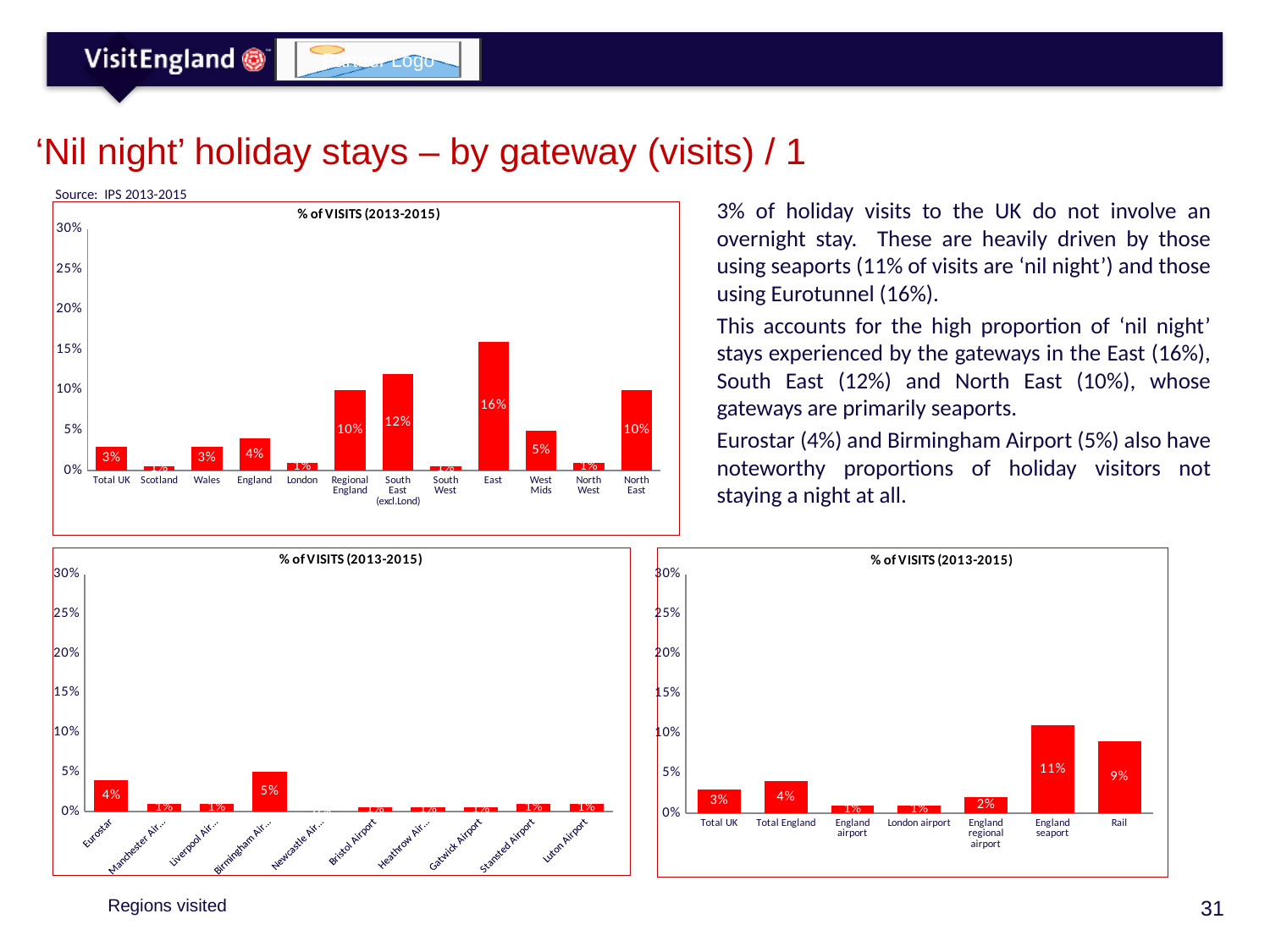
In the bottom-left chart, which category has the highest value? Birmingham Airport In the top-left chart, which is larger, Regional England or West Mids? Regional England In the bottom-right chart, what is the value for England seaport? 11% What type of chart is the bottom-right chart? Bar chart How many categories are shown in the bottom-right chart? 7 In the top-left chart, what is the difference between South East (excl.Lond) and North East? 2% In the top-left chart, which category has the highest value? East How many categories are shown in the top-left chart? 12 In the top-left chart, is the value for East greater or less than 15%? greater In the top-left chart, what is the value for East? 16% In the bottom-left chart, what is the value for Birmingham Airport? 5% In the bottom-right chart, what is the difference between England seaport and Rail? 2%